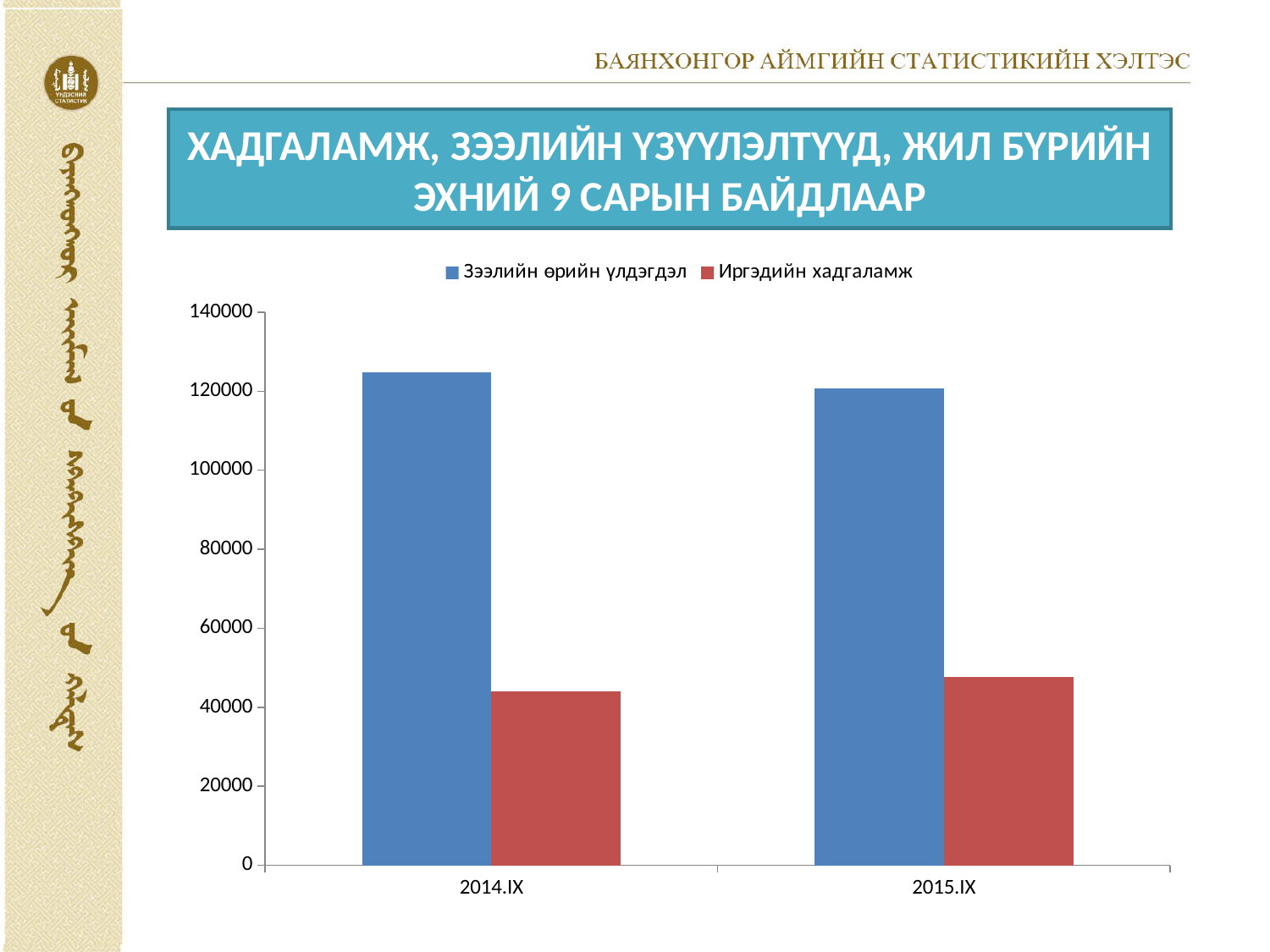
Is the value for Зээлийн өрийн үлдэгдэл in 2014.IX greater or less than 120000? greater Which category has the higher value for Зээлийн өрийн үлдэгдэл, 2014.IX or 2015.IX? 2014.IX Which series is shown in red? Иргэдийн хадгаламж Does the value for Иргэдийн хадгаламж rise or fall from 2014.IX to 2015.IX? rise Which series is shown in blue? Зээлийн өрийн үлдэгдэл Is the value for Иргэдийн хадгаламж in 2015.IX greater or less than 60000? less What kind of chart is shown on the slide? bar chart How many series does the legend list? 2 Is the value for Иргэдийн хадгаламж in 2014.IX greater or less than 40000? greater Which category has the higher value for Иргэдийн хадгаламж, 2014.IX or 2015.IX? 2015.IX How many categories are shown on the x axis? 2